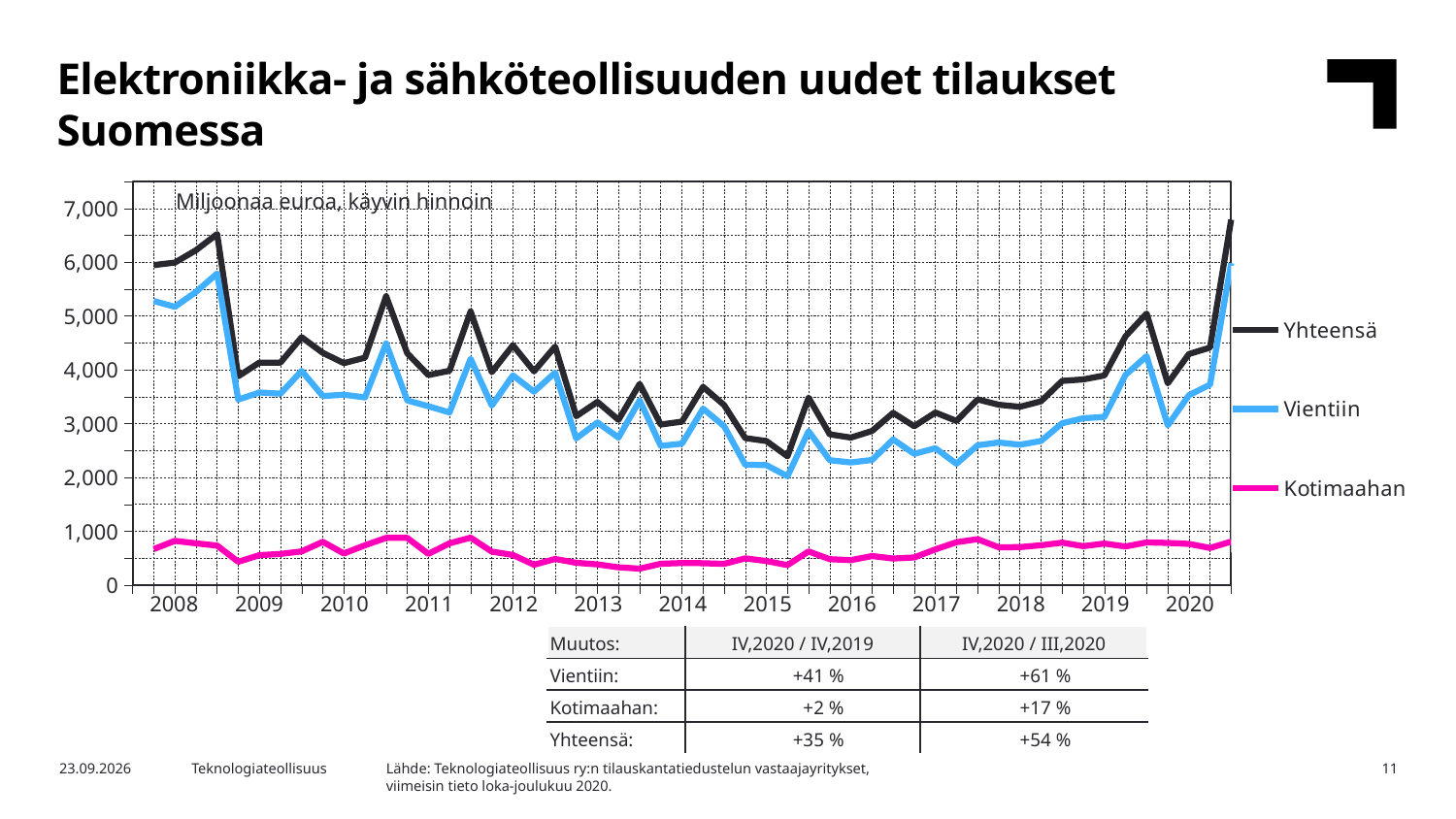
Which series has the highest values throughout the chart? Yhteensä Is the value for Yhteensä at the last point in 2020 greater or less than 6,000? greater What unit is stated inside the chart area? Miljoonaa euroa, käyvin hinnoin What kind of chart is shown on the slide? Line chart Is the value for Kotimaahan at the start of 2008 greater or less than 1,000? less Is the value for Yhteensä at the start of 2016 greater or less than 4,000? less How many series does the chart legend list? 3 Does the Yhteensä series overall rise or fall between 2008 and 2016? Fall Which is larger at the start of 2012, the value for Vientiin or the value for Kotimaahan? Vientiin Which series has the lowest values throughout the chart? Kotimaahan What colour is the Vientiin line in the chart? Blue